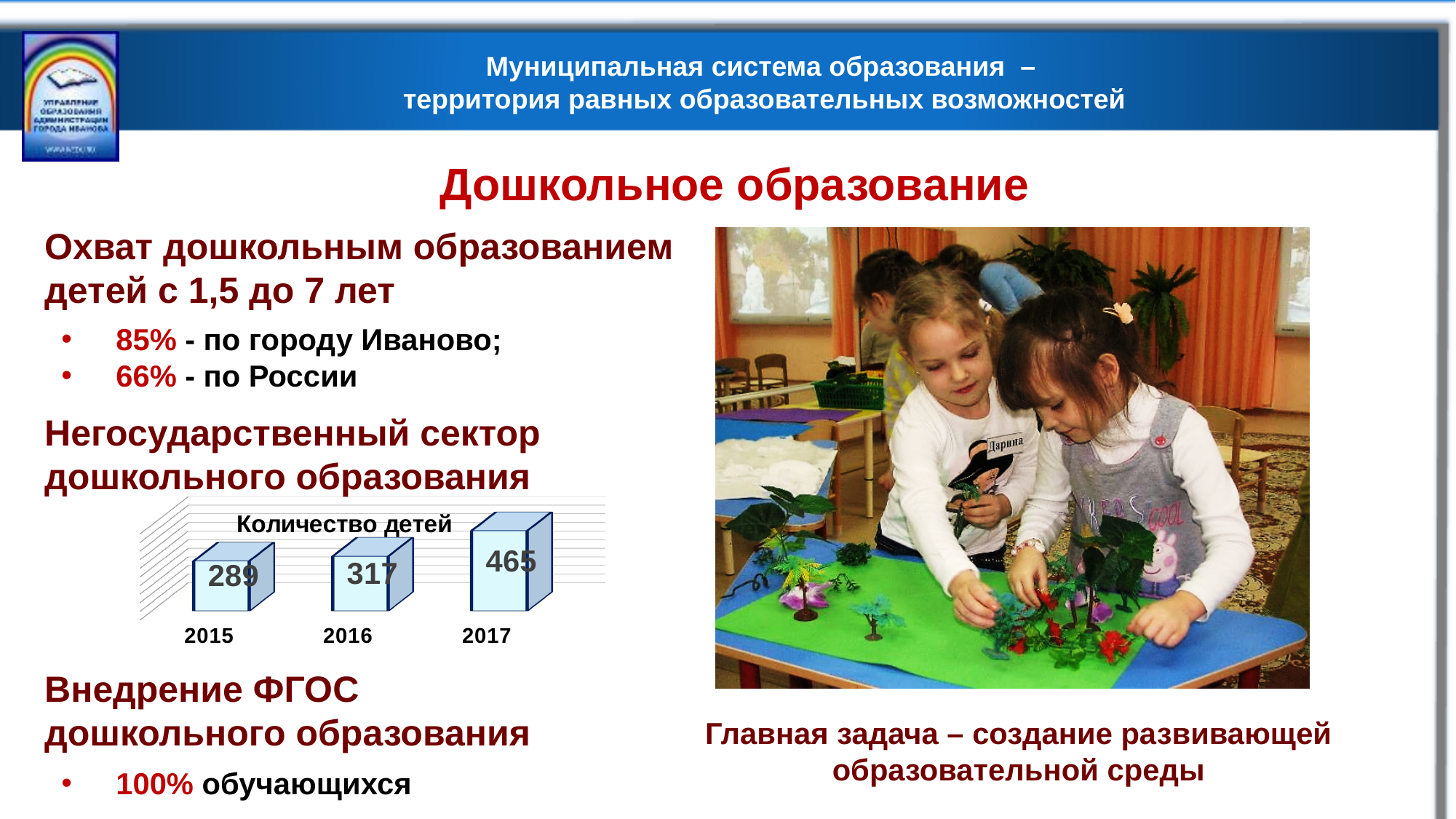
What is the difference between the values for 2017 and 2016 in the chart titled "Количество детей"? 148 In the chart titled "Количество детей", which is larger, the value for 2015 or the value for 2017? 2017 What is the value for 2016 in the chart titled "Количество детей"? 317 What kind of chart is the chart titled "Количество детей"? bar chart Do the values in the chart titled "Количество детей" rise or fall from 2015 to 2017? rise What is the value for 2017 in the chart titled "Количество детей"? 465 How many years are shown in the chart titled "Количество детей"? 3 What is the title of the chart on the slide? Количество детей What is the value for 2015 in the chart titled "Количество детей"? 289 Which year has the highest value in the chart titled "Количество детей"? 2017 What is the difference between the values for 2016 and 2015 in the chart titled "Количество детей"? 28 Which year has the lowest value in the chart titled "Количество детей"? 2015